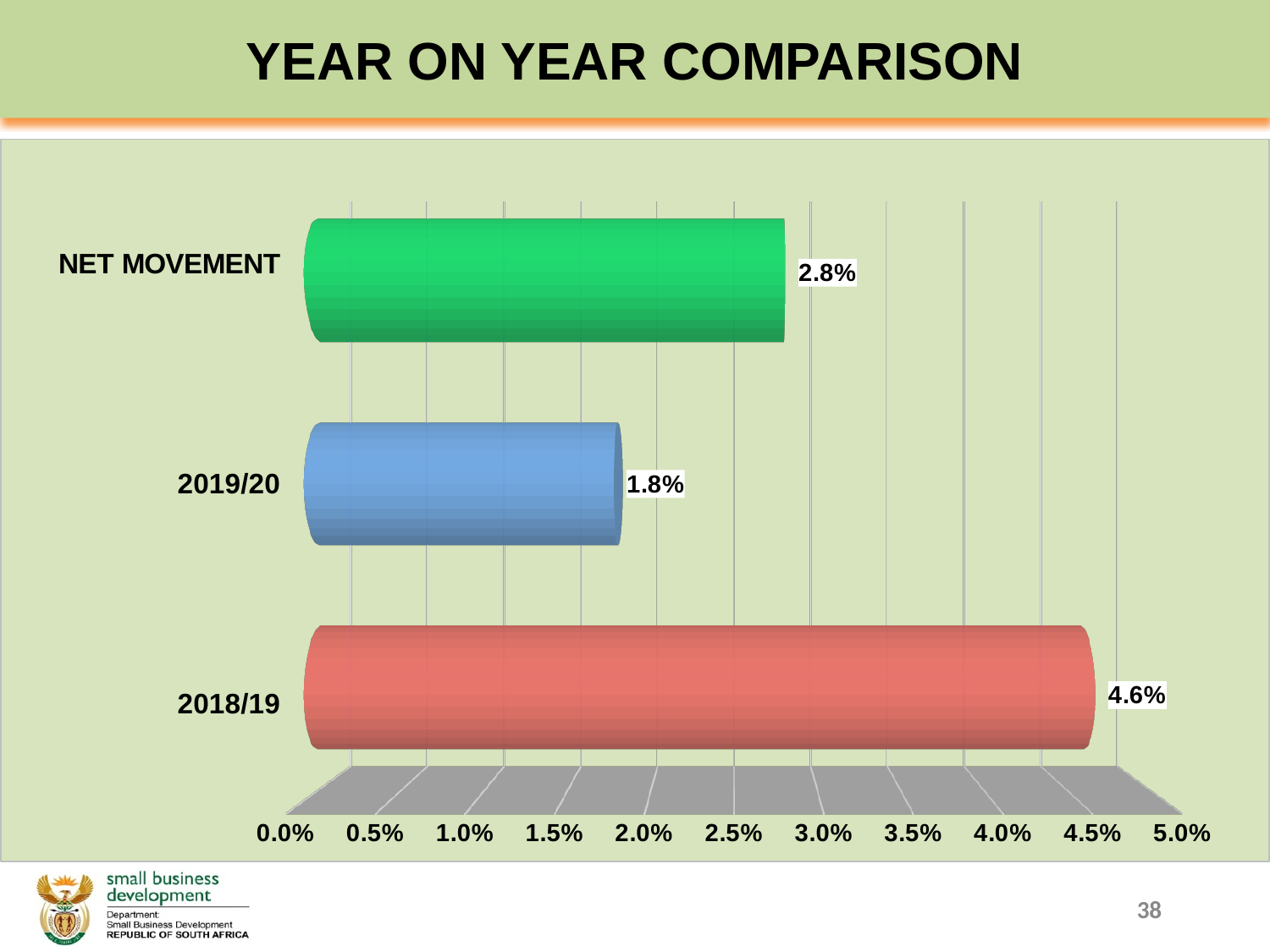
What is the value for 2018/19? 4.6% Is the value for 2019/20 greater or less than 2.0%? less What is the difference between the values for 2018/19 and 2019/20? 2.8% What is the title of the slide? YEAR ON YEAR COMPARISON Which is larger, the value for NET MOVEMENT or the value for 2019/20? NET MOVEMENT Which category has the highest value? 2018/19 Is the value for 2018/19 greater or less than 4.0%? greater What kind of chart is shown on the slide? bar chart How many categories are shown in the chart? 3 What is the value for 2019/20? 1.8% Which category has the lowest value? 2019/20 What is the value for NET MOVEMENT? 2.8%